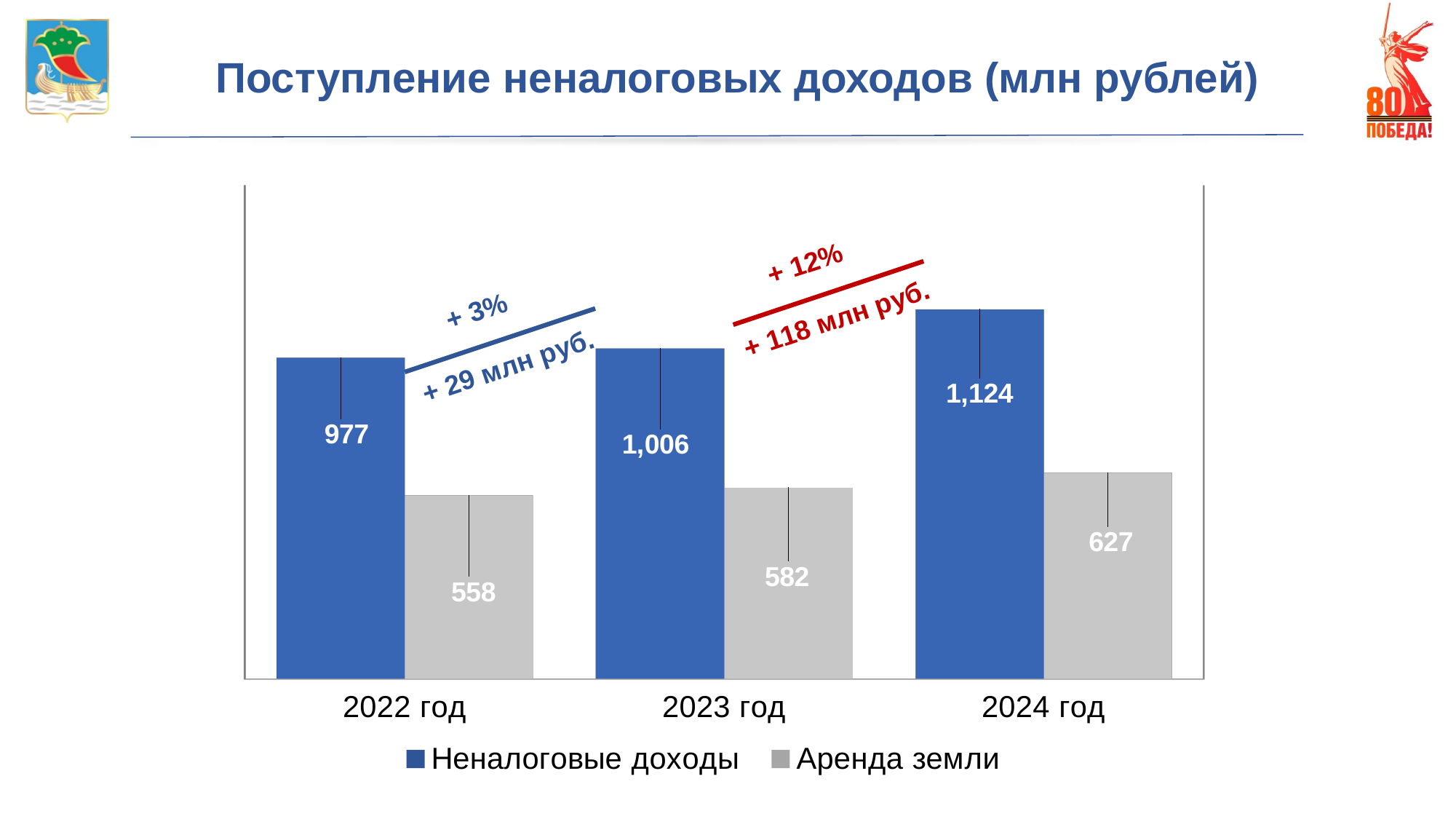
What is the value of Аренда земли for 2024 год? 627 Which year has the lowest value for Аренда земли? 2022 год What is the difference in Аренда земли between 2024 год and 2023 год? 45 Do the values for Неналоговые доходы rise or fall from 2022 год to 2024 год? Rise Which is larger: Аренда земли in 2022 год or Аренда земли in 2024 год? Аренда земли in 2024 год How many series does the legend list? 2 What is the value of Неналоговые доходы for 2023 год? 1,006 What is the difference between Неналоговые доходы and Аренда земли in 2023 год? 424 How many years are shown on the x axis? 3 What kind of chart is shown on the slide? Bar chart Which year has the highest value for Неналоговые доходы? 2024 год What is the value of Неналоговые доходы for 2022 год? 977